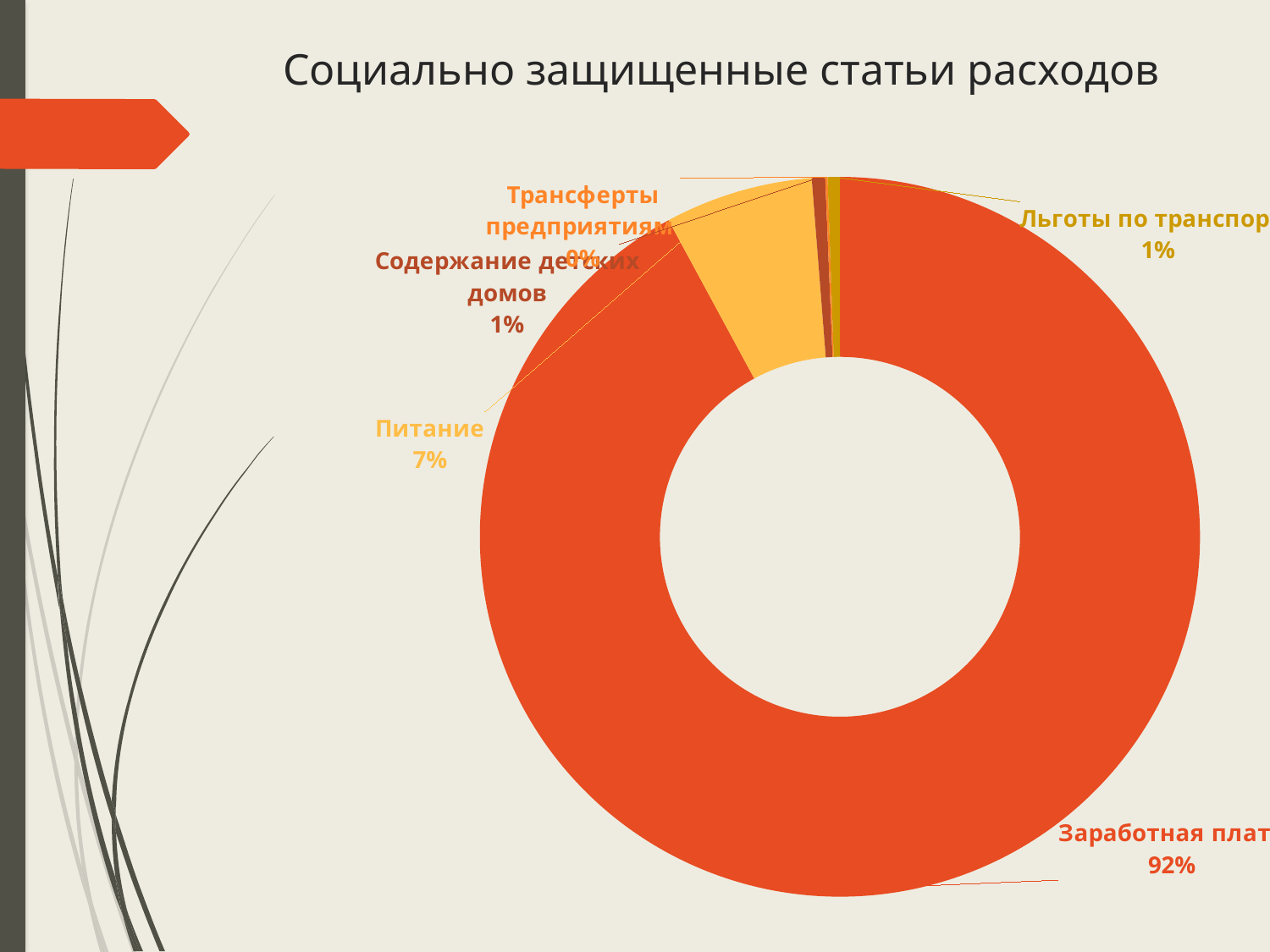
How many percentage points larger is the share for Заработная плата than the share for Питание? 85 What share of the chart does Заработная плата take? 92% What percentage is shown for Трансферты предприятиям? 0% Which is larger, the share for Питание or the share for Содержание детских домов? Питание What share of the chart does Питание take? 7% Which category has the largest share of the chart? Заработная плата What percentage is shown for Льготы по транспорту? 1% Which category has the smallest share of the chart? Трансферты предприятиям What kind of chart is shown on the slide? Doughnut (pie) chart How many categories are shown in the chart? 5 What percentage is shown for Содержание детских домов? 1% What is the title of the chart? Социально защищенные статьи расходов